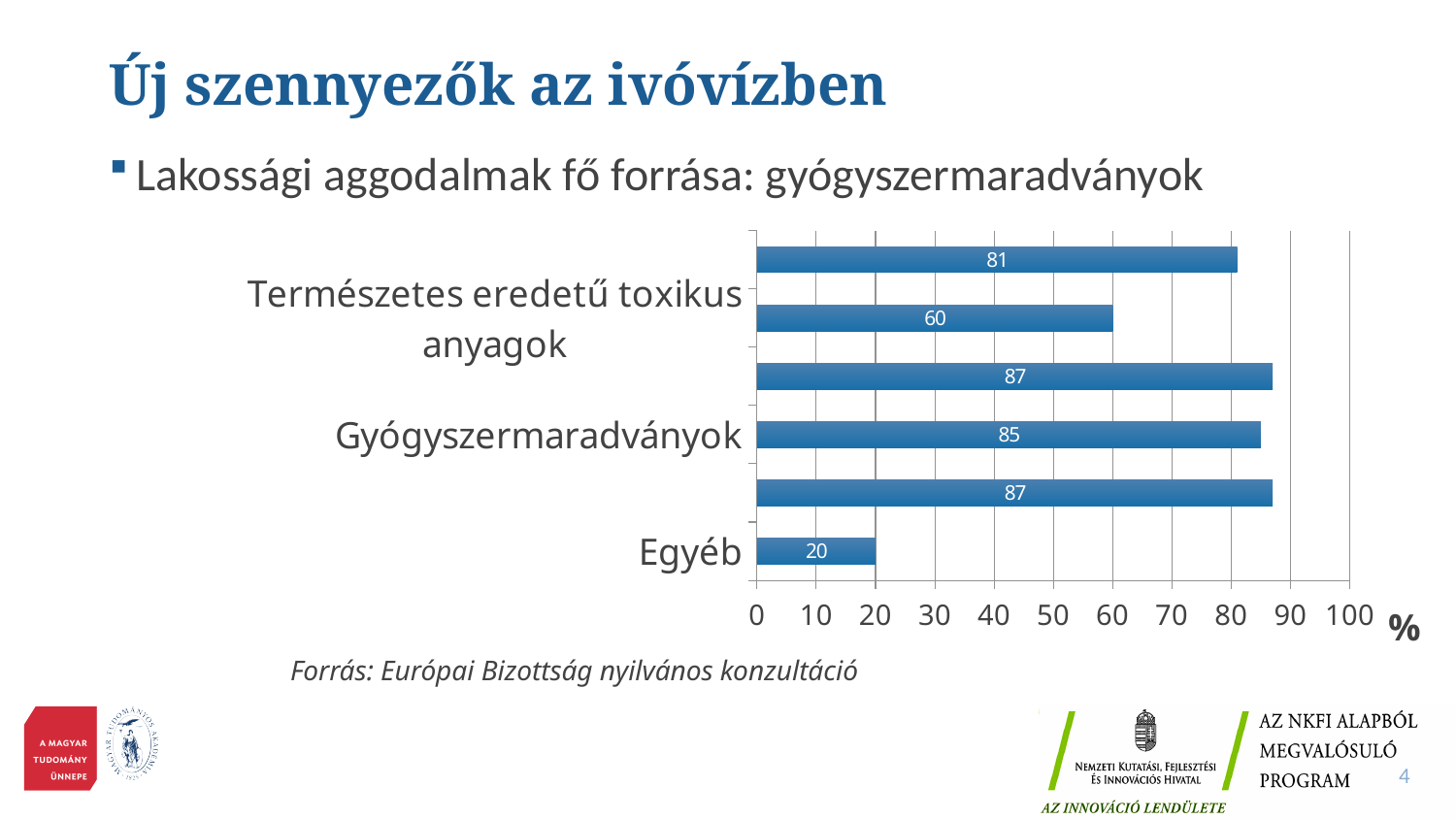
How many bars are plotted in the chart? 6 Which is larger, the value for Gyógyszermaradványok or the value for Egyéb? Gyógyszermaradványok What kind of chart is shown on the slide? bar chart What unit is shown at the end of the horizontal axis? % What is the value for Egyéb? 20 What is the difference between the values for Gyógyszermaradványok and Természetes eredetű toxikus anyagok? 25 Which labelled category has the lowest value? Egyéb What is the value for Természetes eredetű toxikus anyagok? 60 What is the highest tick value shown on the horizontal axis? 100 What is the difference between the values for Gyógyszermaradványok and Egyéb? 65 What is the value for Gyógyszermaradványok? 85 Is the value for Egyéb greater or less than 30? less